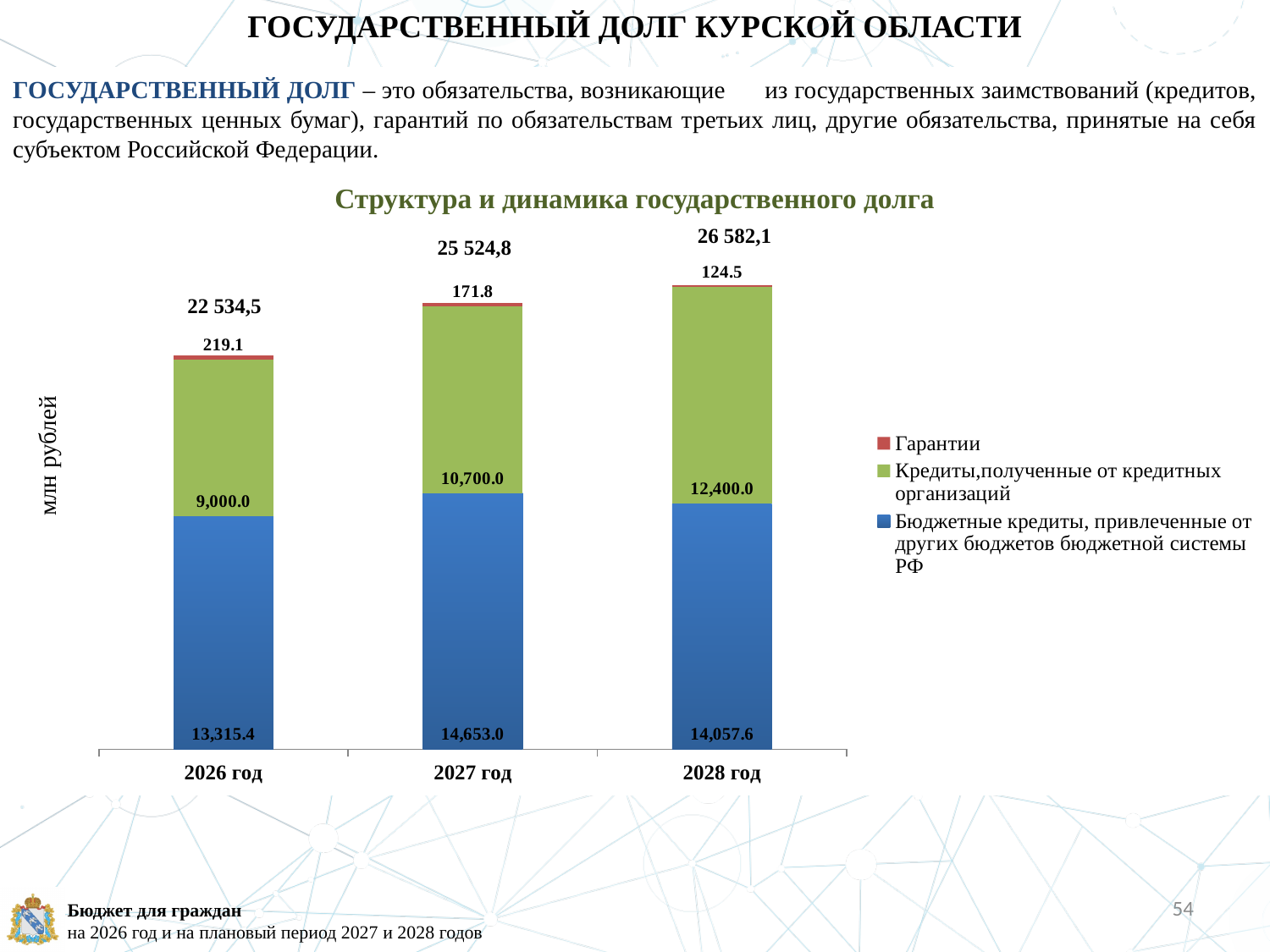
What is the value of Бюджетные кредиты, привлеченные от других бюджетов бюджетной системы РФ for 2026 год? 13,315.4 What is the value of Кредиты, полученные от кредитных организаций for 2028 год? 12,400.0 Which year has the highest total state debt? 2028 год How many years are shown on the x axis? 3 What is the total state debt shown above the bar for 2027 год? 25 524,8 What type of chart is shown on the slide? Stacked bar chart Which year has the lowest value for Гарантии? 2028 год Does the total state debt rise or fall from 2026 год to 2028 год? Rises Which is larger: Бюджетные кредиты for 2027 год or for 2028 год? 2027 год How many series does the legend list? 3 What is the difference between the Кредиты, полученные от кредитных организаций values for 2028 год and 2026 год? 3,400.0 What is the value of Гарантии for 2027 год? 171.8